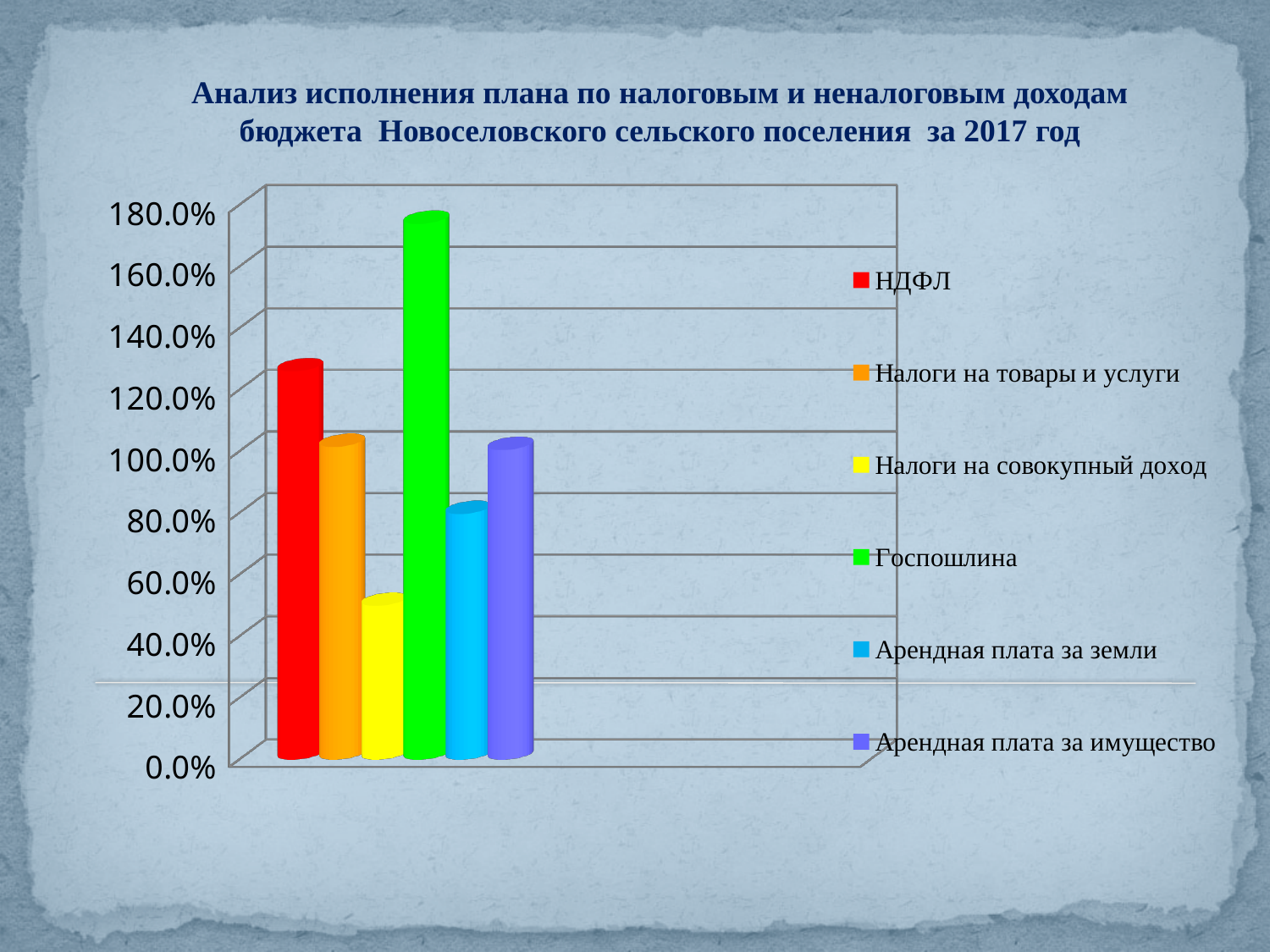
Which series has the highest value in the chart? Госпошлина Which series has the lowest value in the chart? Налоги на совокупный доход Which colour represents Госпошлина in the legend? green What kind of chart is shown on the slide? bar chart How many series does the legend list? 6 How many bars are plotted in the chart? 6 Is the value for Налоги на совокупный доход greater or less than 60.0%? less Which is larger, the value for Госпошлина or the value for НДФЛ? Госпошлина Which is larger, the value for НДФЛ or the value for Арендная плата за земли? НДФЛ Is the value for Госпошлина greater or less than 160.0%? greater Is the value for НДФЛ greater or less than 120.0%? greater